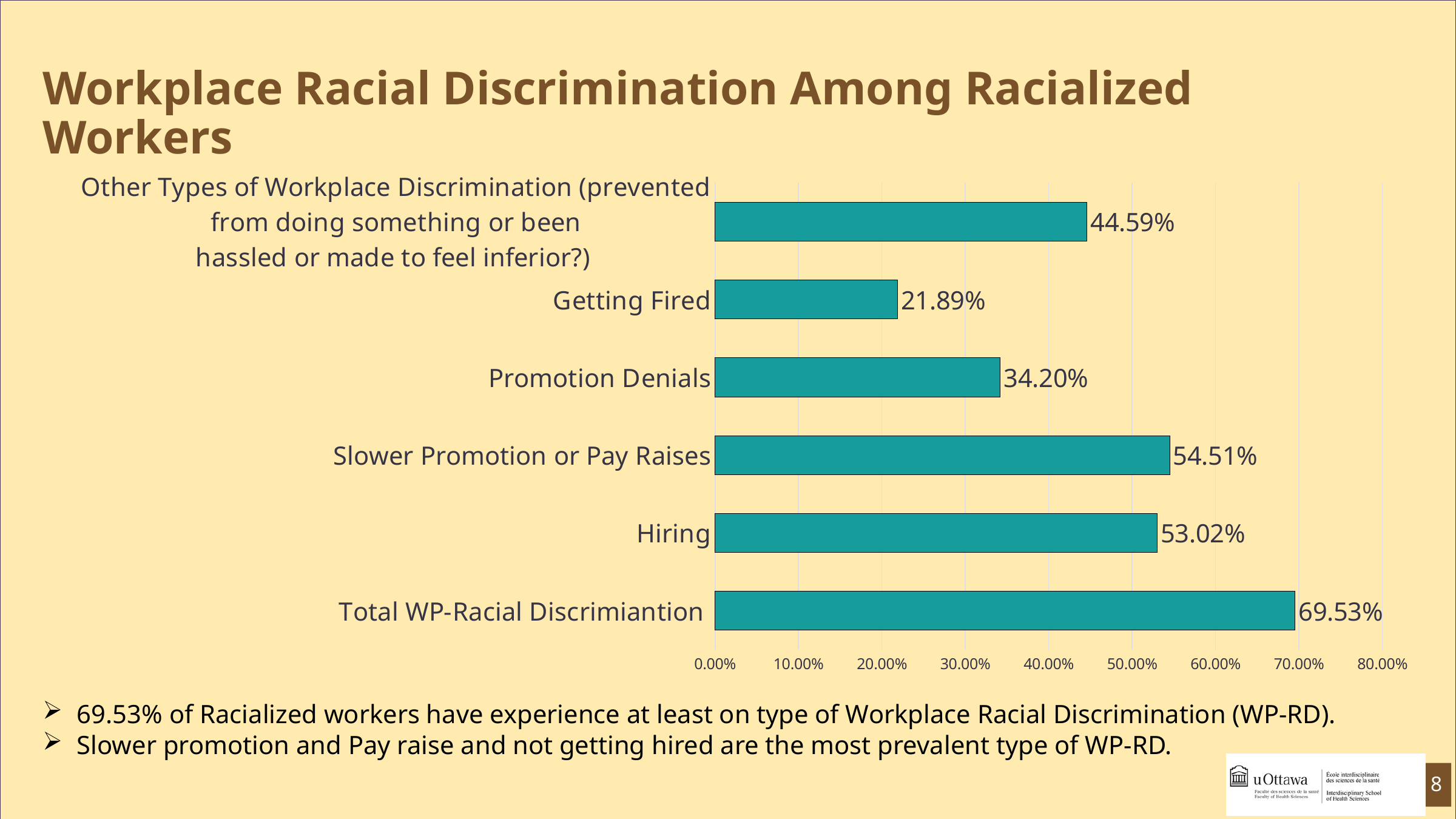
Is the value for Slower Promotion or Pay Raises greater or less than 50.00%? greater What kind of chart is shown on the slide? bar chart What is the value for Hiring? 53.02% What is the value for Getting Fired? 21.89% What is the difference between the values for Total WP-Racial Discrimiantion and Hiring? 16.51% What is the value for Promotion Denials? 34.20% What is the value for Slower Promotion or Pay Raises? 54.51% What is the value for Other Types of Workplace Discrimination (prevented from doing something or been hassled or made to feel inferior?)? 44.59% Which category has the highest value? Total WP-Racial Discrimiantion Which category has the lowest value? Getting Fired How many categories are shown in the chart? 6 Which is larger, the value for Promotion Denials or the value for Getting Fired? Promotion Denials